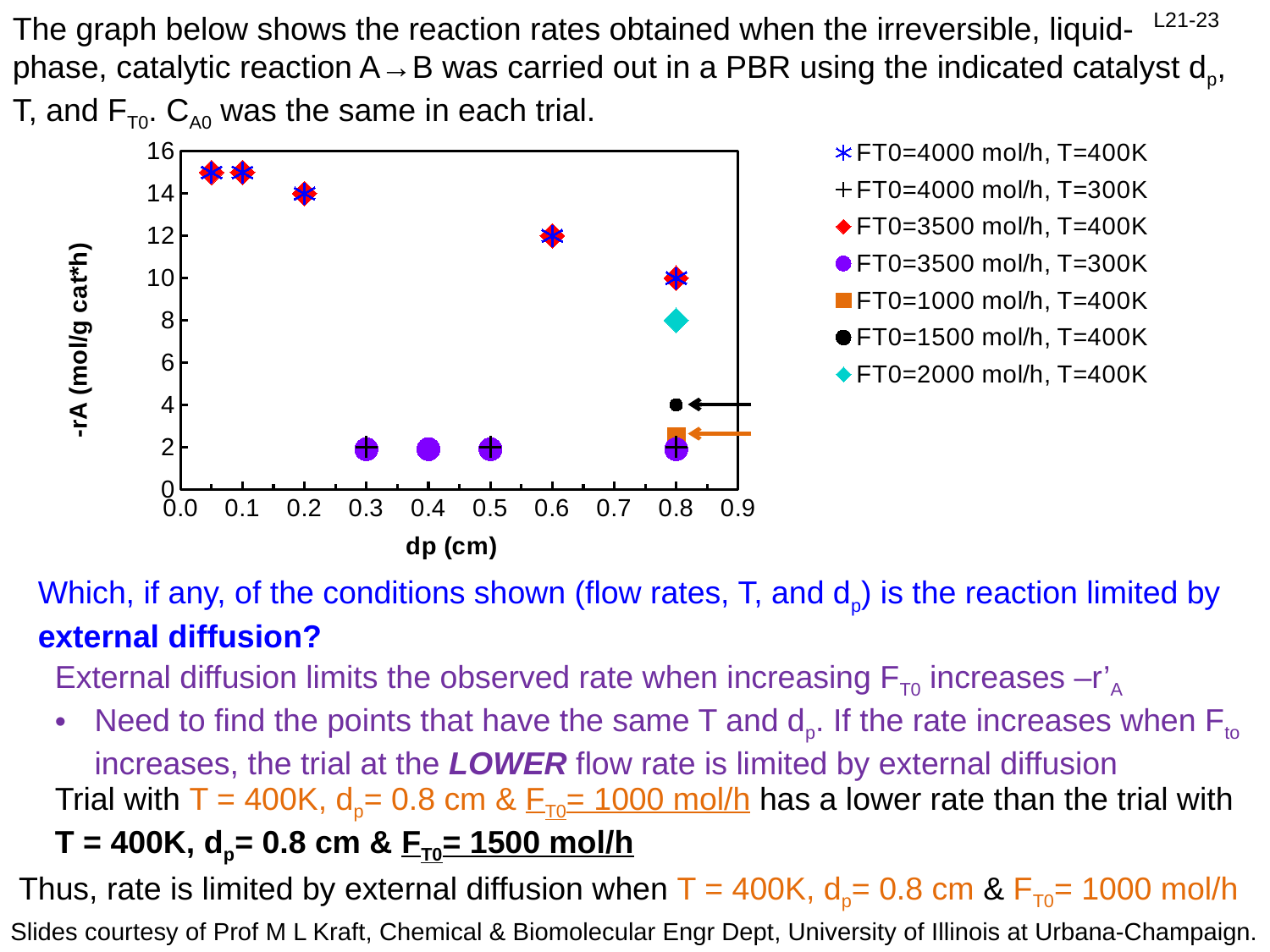
Is the reaction rate for FT0=1000 mol/h, T=400K at dp = 0.8 cm greater or less than 4? less What is the reaction rate for FT0=3500 mol/h, T=400K at dp = 0.6 cm? 12 What is the reaction rate for FT0=1500 mol/h, T=400K at dp = 0.8 cm? 4 At dp = 0.8 cm, what is the difference in reaction rate between FT0=2000 mol/h, T=400K and FT0=1500 mol/h, T=400K? 4 What is the reaction rate for FT0=4000 mol/h, T=400K at dp = 0.2 cm? 14 What is the reaction rate for FT0=2000 mol/h, T=400K at dp = 0.8 cm? 8 What kind of chart is shown on the slide? scatter chart What is the label of the x axis? dp (cm) At dp = 0.8 cm and T=400K, which has the higher reaction rate: FT0=2000 mol/h or FT0=1500 mol/h? FT0=2000 mol/h Is the reaction rate for FT0=4000 mol/h, T=400K at dp = 0.05 cm greater or less than 14? greater For the FT0=4000 mol/h, T=400K series, does the reaction rate rise or fall as dp increases? fall How many series does the legend list? 7